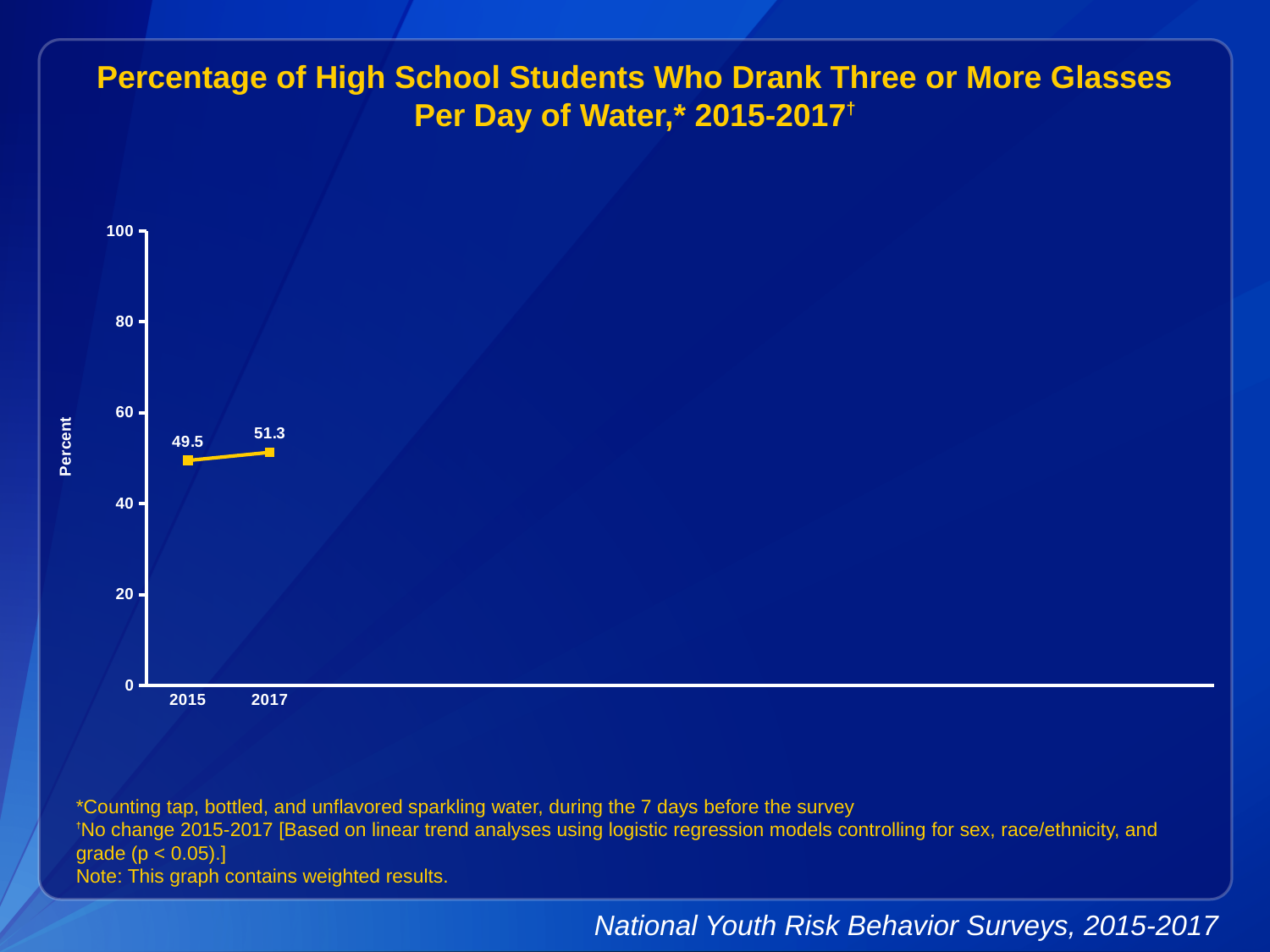
How many years are plotted on the chart? 2 Is the value for 2017 greater or less than 40? greater What is the difference between the 2017 value and the 2015 value? 1.8 Does the value rise or fall from 2015 to 2017? rise Which year has the lower value on the chart? 2015 Is the value for 2015 greater or less than 60? less What kind of chart is shown on the slide? line chart What is the maximum value shown on the y axis? 100 What is the label on the y axis of the chart? Percent What percentage of high school students drank three or more glasses of water per day in 2017? 51.3 Which year has the higher value, 2015 or 2017? 2017 What percentage of high school students drank three or more glasses of water per day in 2015? 49.5